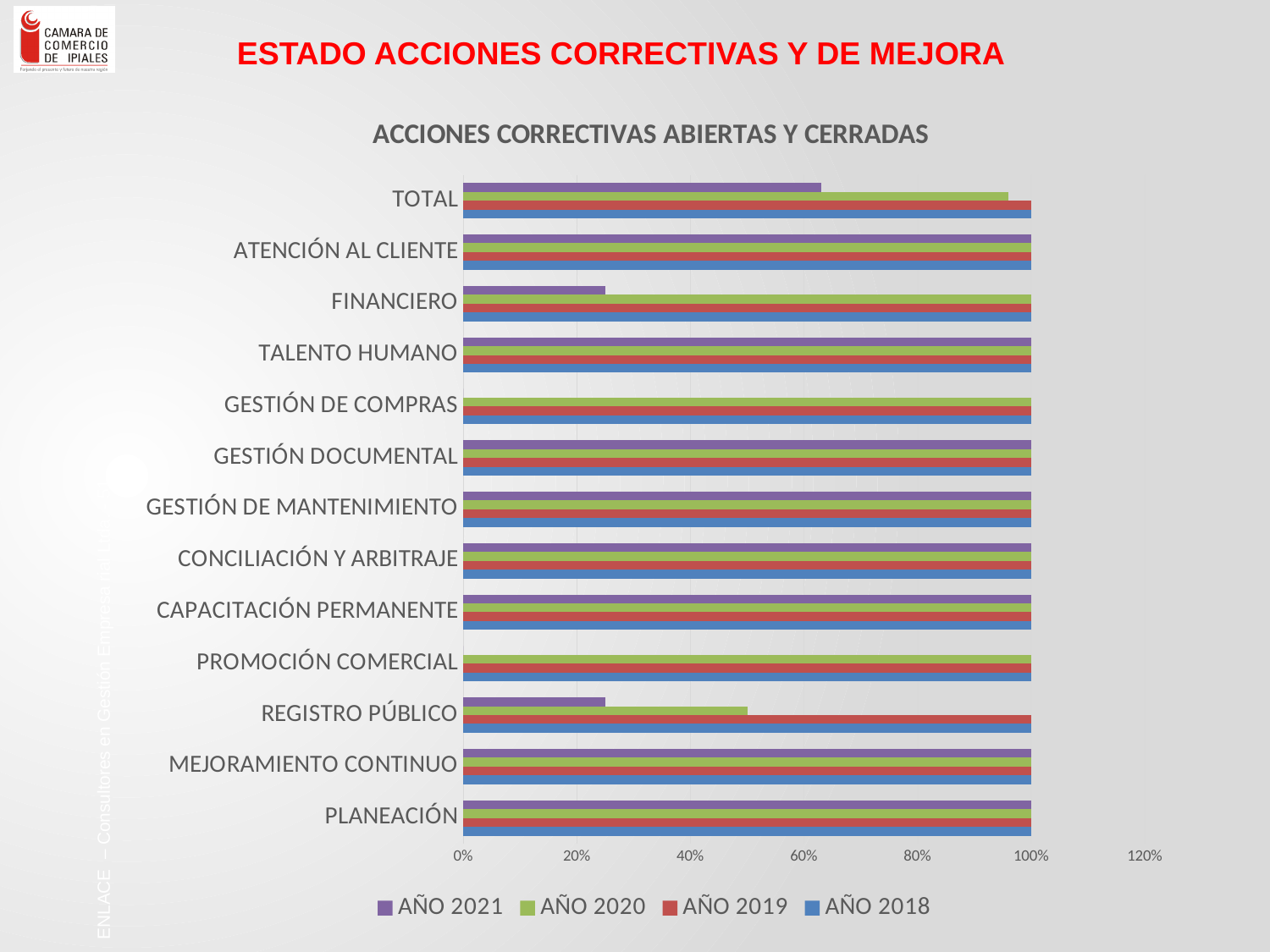
Which category has the lowest value in the AÑO 2020 series? REGISTRO PÚBLICO Is the value for TOTAL in the AÑO 2021 series greater or less than 80%? less Is the value for REGISTRO PÚBLICO in the AÑO 2020 series greater or less than 80%? less Is the value for TOTAL in the AÑO 2020 series greater or less than 80%? greater How many categories are shown on the vertical axis of the chart? 13 What is the title of the chart? ACCIONES CORRECTIVAS ABIERTAS Y CERRADAS What is the value for TOTAL in the AÑO 2019 series? 100% How many series does the legend list? 4 What kind of chart is shown on the slide? bar chart What is the value for PLANEACIÓN in the AÑO 2018 series? 100% For TOTAL, which is larger: the AÑO 2021 value or the AÑO 2020 value? AÑO 2020